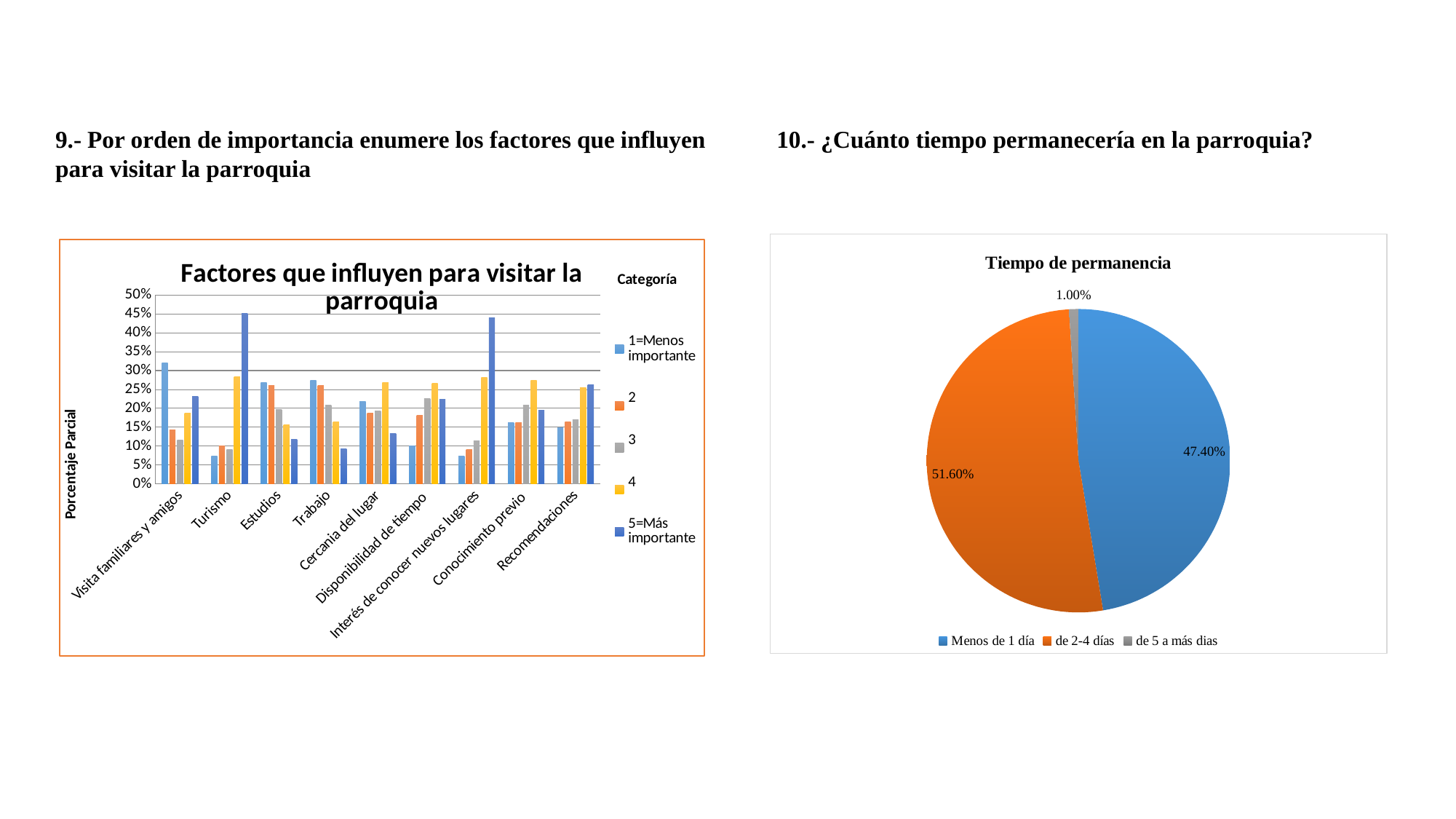
In the pie chart 'Tiempo de permanencia', which category has the smallest slice? de 5 a más dias How many categories are shown on the x axis of the chart 'Factores que influyen para visitar la parroquia'? 9 In the pie chart 'Tiempo de permanencia', what share is shown for 'de 2-4 días'? 51.60% How many series does the legend of the chart 'Factores que influyen para visitar la parroquia' list? 5 In the chart 'Factores que influyen para visitar la parroquia', which category has the highest '1=Menos importante' bar? Visita familiares y amigos What kind of chart is 'Factores que influyen para visitar la parroquia'? Bar chart In the pie chart 'Tiempo de permanencia', which category has the largest slice? de 2-4 días In the chart 'Factores que influyen para visitar la parroquia', is the '5=Más importante' value for 'Turismo' greater or less than 40%? greater In the pie chart 'Tiempo de permanencia', how many percentage points larger is 'de 2-4 días' than 'Menos de 1 día'? 4.20% In the pie chart 'Tiempo de permanencia', what share is shown for 'Menos de 1 día'? 47.40% In the chart 'Factores que influyen para visitar la parroquia', is the '1=Menos importante' value for 'Turismo' greater or less than 10%? less How many slices does the pie chart 'Tiempo de permanencia' have? 3